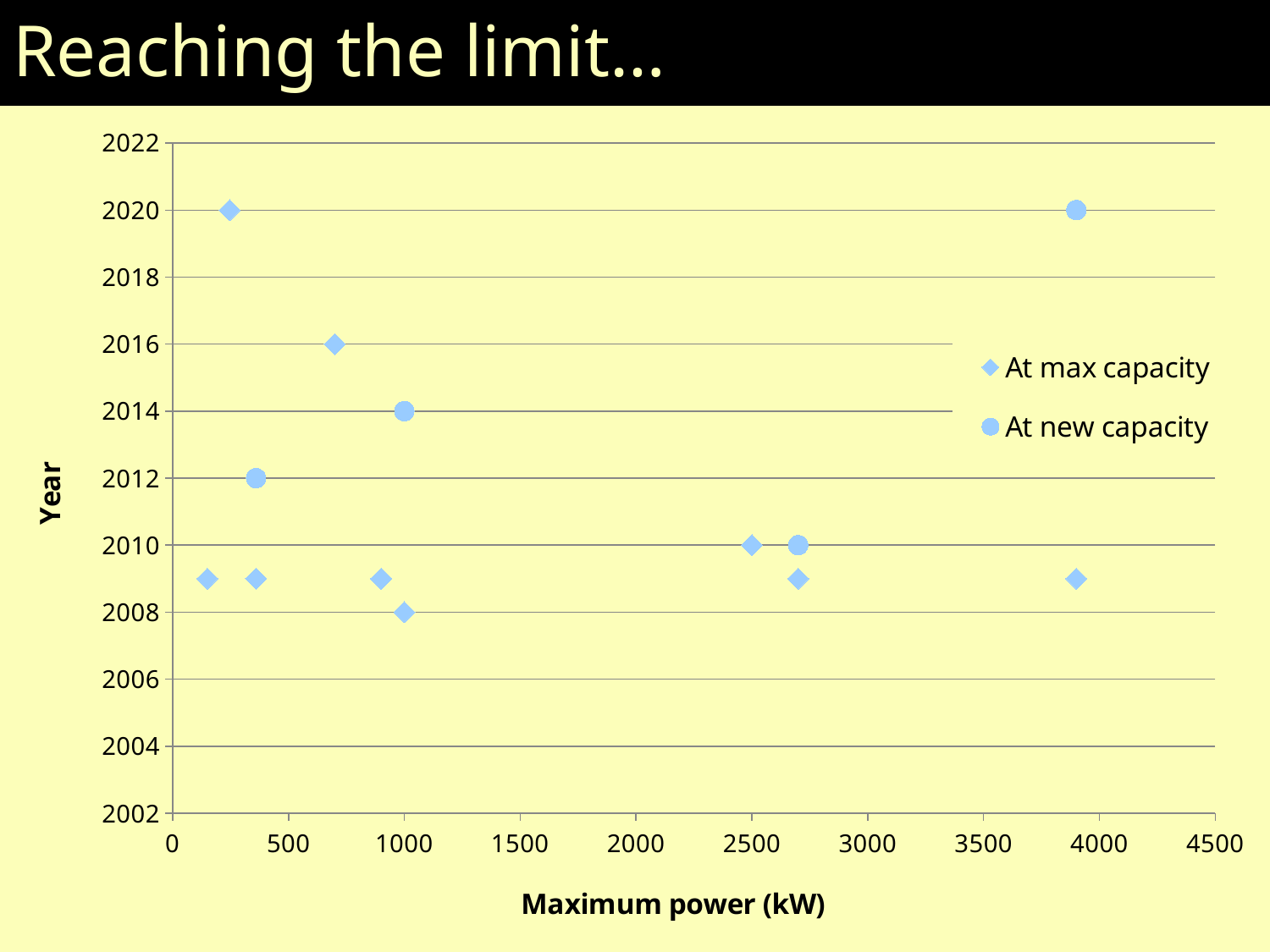
How many 'At new capacity' points are plotted? 4 At year 2020, which series has the point with the larger maximum power, 'At max capacity' or 'At new capacity'? At new capacity How many 'At max capacity' points are plotted? 9 Is the maximum power of the 'At new capacity' point at year 2020 greater or less than 3500? greater What are the two series named in the legend? At max capacity; At new capacity What is the maximum power (kW) of the 'At max capacity' point plotted at year 2010? 2500 How many series does the legend list? 2 What is the title of the horizontal axis? Maximum power (kW) What is the maximum power (kW) of the 'At new capacity' point plotted at year 2014? 1000 What is the maximum power (kW) of the 'At max capacity' point plotted at year 2008? 1000 Is the maximum power of the 'At new capacity' point at year 2012 greater or less than 500? less What kind of chart is shown on the slide? scatter chart